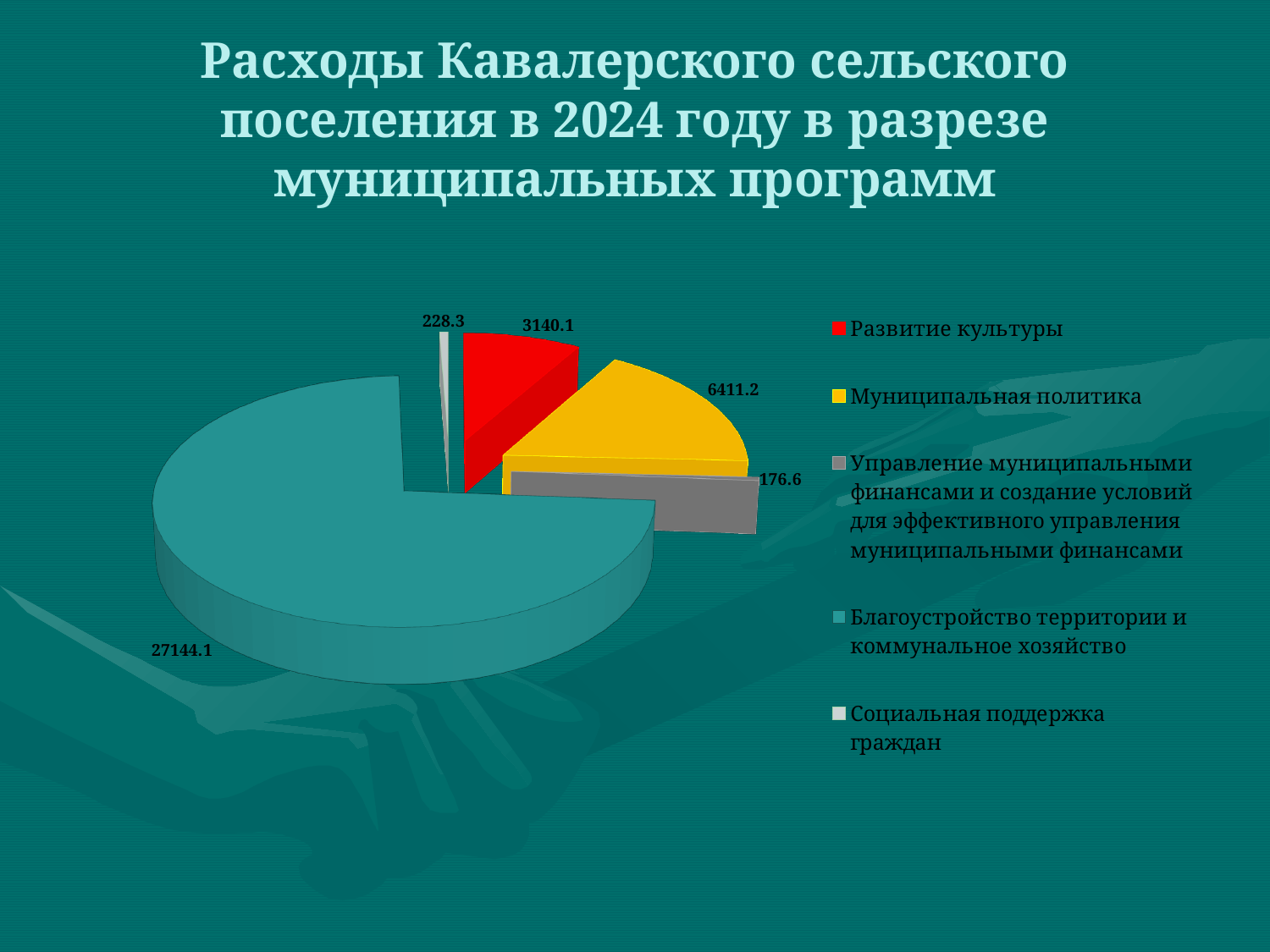
Which category has the largest slice of the pie? Благоустройство территории и коммунальное хозяйство Which is larger: Развитие культуры or Муниципальная политика? Муниципальная политика How many categories does the legend list? 5 What colour is the slice for Развитие культуры? Red What is the difference between the values for Муниципальная политика and Развитие культуры? 3271.1 What is the value for Развитие культуры? 3140.1 What is the value for Управление муниципальными финансами и создание условий для эффективного управления муниципальными финансами? 176.6 Which category has the smallest value? Управление муниципальными финансами и создание условий для эффективного управления муниципальными финансами What type of chart is shown on the slide? Pie chart What is the value for Муниципальная политика? 6411.2 What is the value for Социальная поддержка граждан? 228.3 What is the value for Благоустройство территории и коммунальное хозяйство? 27144.1